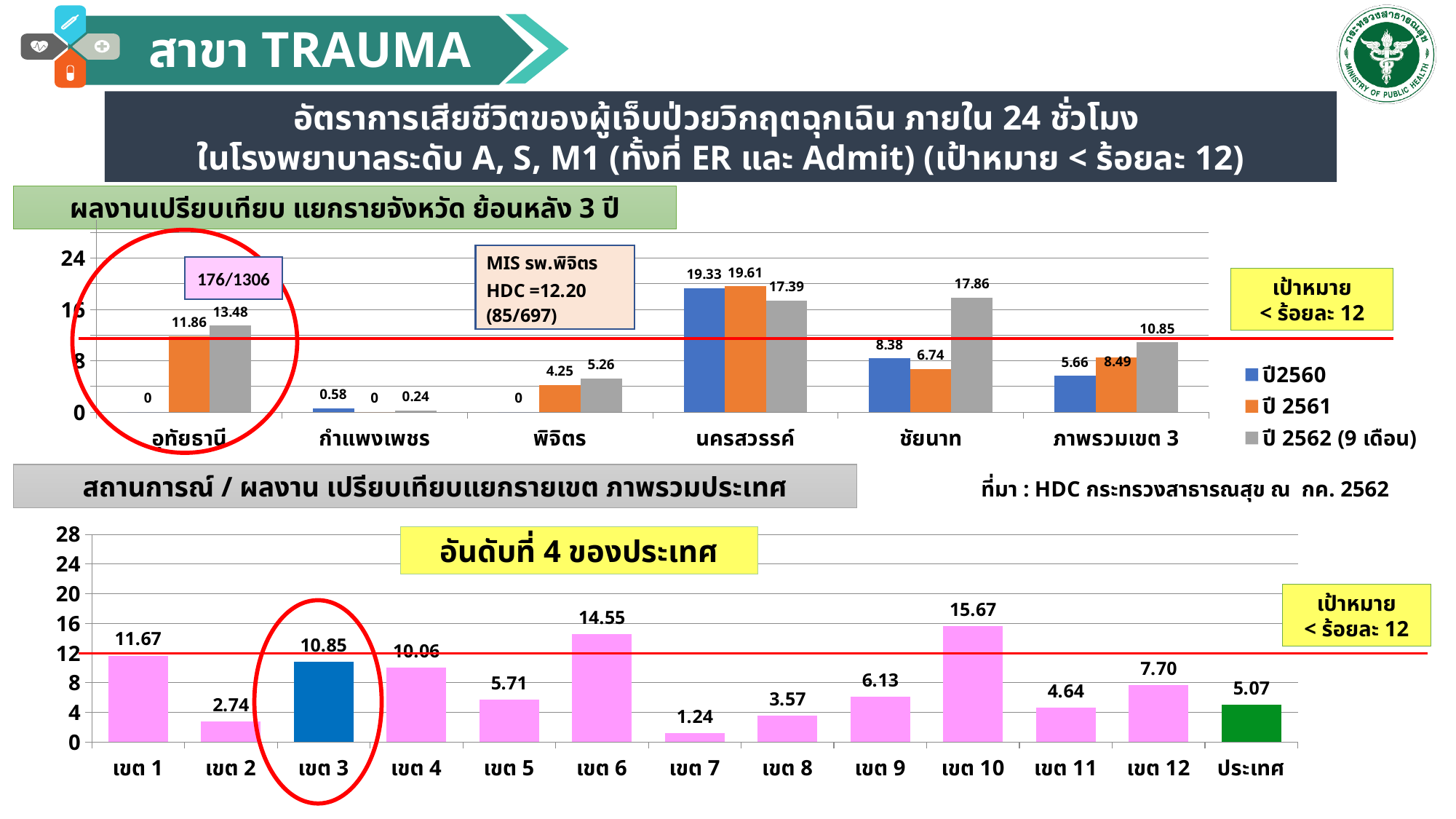
What kind of chart is the bottom chart (by region)? bar chart In the top chart (by province, 3 years), what is the difference between the ปี 2562 (9 เดือน) and ปี 2561 values for ภาพรวมเขต 3? 2.36 In the top chart (by province, 3 years), how many series does the legend list? 3 In the bottom chart (by region), how many bars are plotted? 13 In the bottom chart (by region), what is the value for เขต 10? 15.67 In the bottom chart (by region), what is the difference between เขต 1 and เขต 3? 0.82 In the top chart (by province, 3 years), what is the value for ชัยนาท in ปี 2562 (9 เดือน)? 17.86 In the bottom chart (by region), which category has the lowest value? เขต 7 In the bottom chart (by region), which category has the highest value? เขต 10 In the top chart (by province, 3 years), what is the value for นครสวรรค์ in ปี 2561? 19.61 In the top chart (by province, 3 years), which is larger for ชัยนาท: the ปี 2560 value or the ปี 2561 value? ปี 2560 In the top chart (by province, 3 years), which province has the highest value in ปี 2560? นครสวรรค์